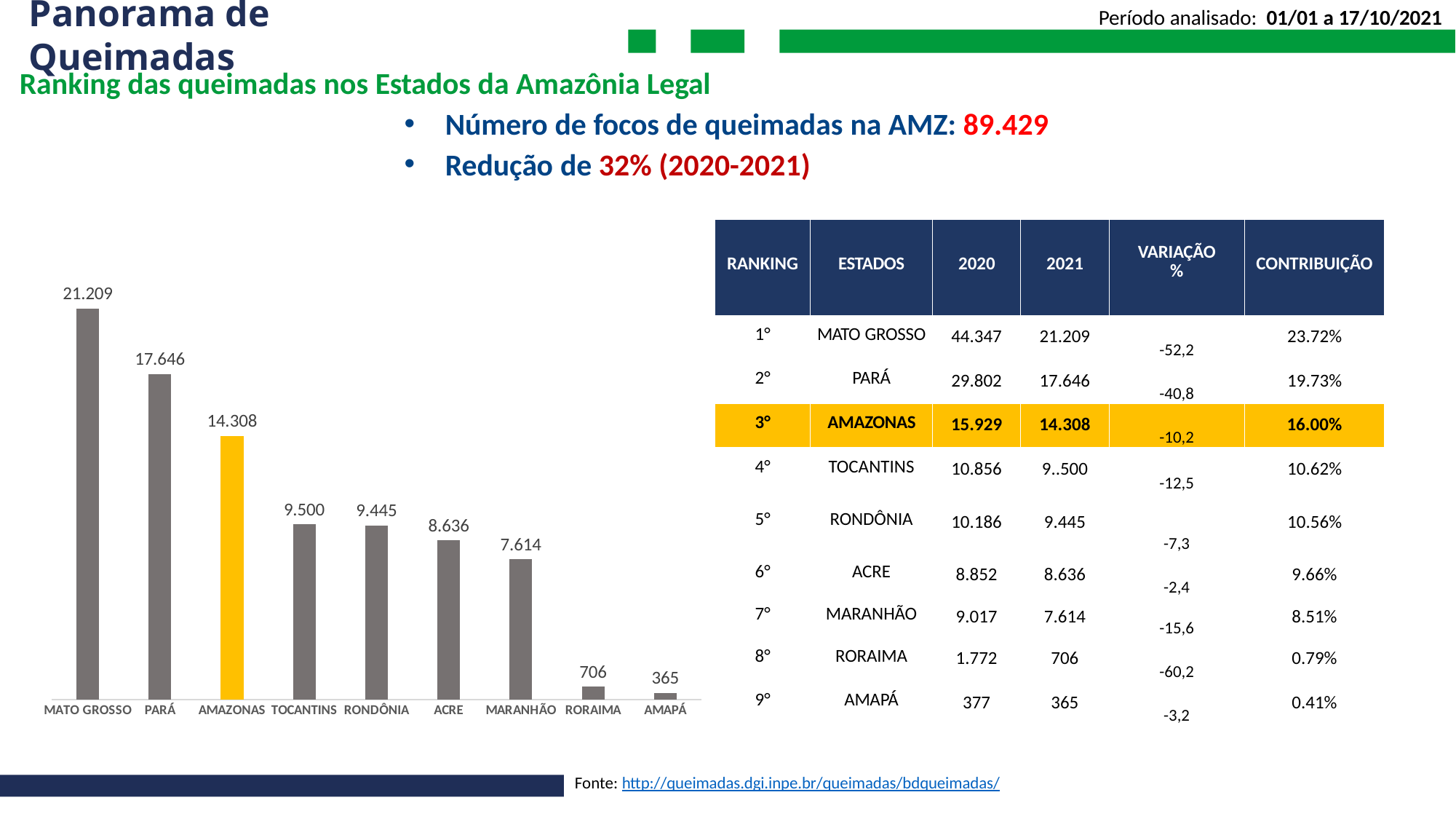
How many states are shown as bars in the chart? 9 What is the difference between the values for RORAIMA and AMAPÁ in the chart? 341 Which state has the highest bar in the chart? MATO GROSSO What is the value shown for RORAIMA in the chart? 706 What is the value shown for MATO GROSSO in the chart? 21.209 Which state has the lowest bar in the chart? AMAPÁ What is the value shown for AMAZONAS in the chart? 14.308 Do the bar values rise or fall from left to right across the chart? fall Which state's bar is highlighted in yellow in the chart? AMAZONAS Which has a larger value in the chart, PARÁ or AMAZONAS? PARÁ What is the difference between the values for MATO GROSSO and PARÁ in the chart? 3.563 What type of chart is shown on the slide? bar chart